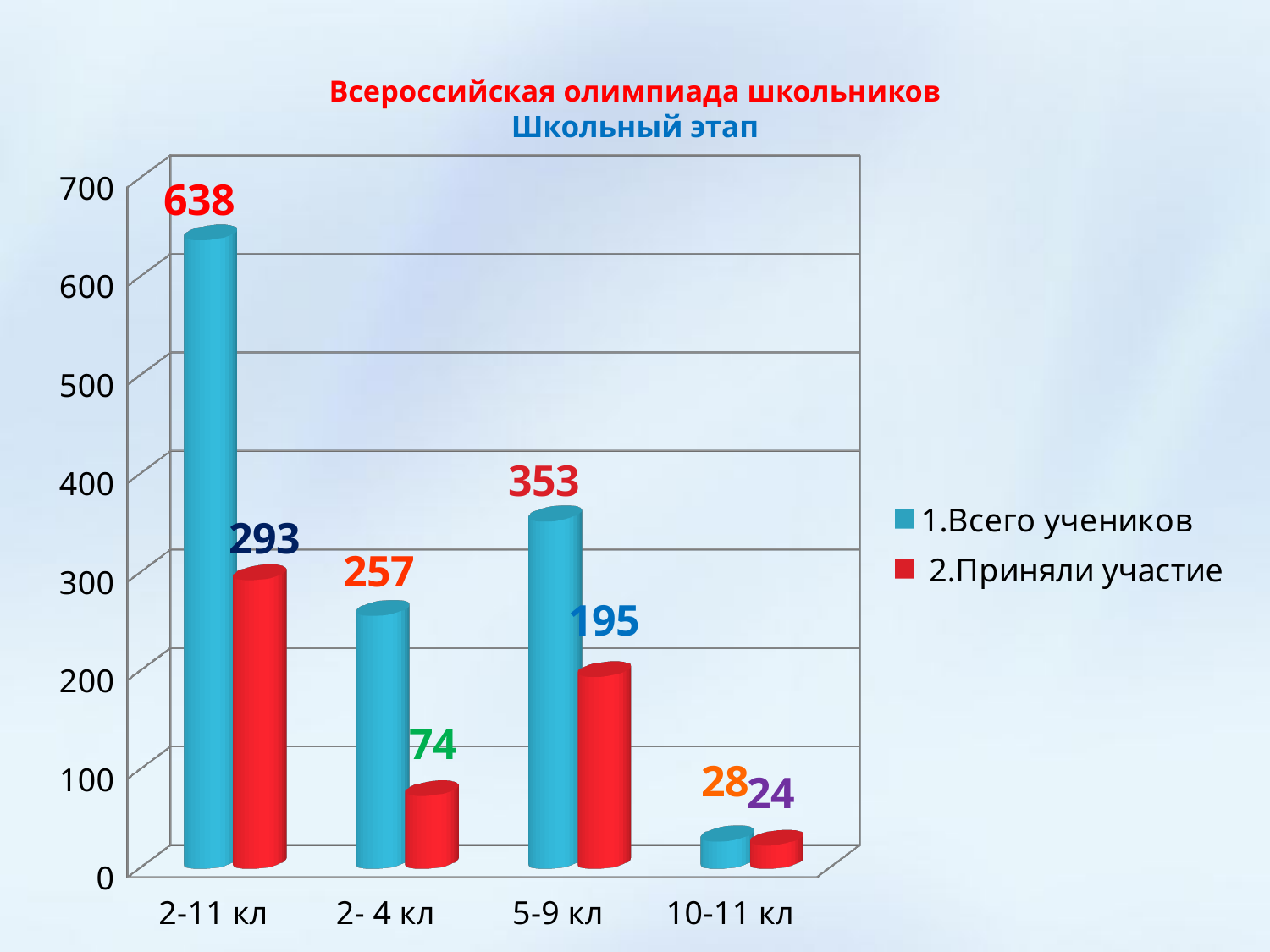
Which is larger: "2.Приняли участие" for "2-11 кл" or "1.Всего учеников" for "2- 4 кл"? 2.Приняли участие for 2-11 кл Which category has the highest value for "1.Всего учеников"? 2-11 кл What kind of chart is shown on the slide? Bar chart How many categories are shown on the x axis? 4 What is the title of the chart? Всероссийская олимпиада школьников Школьный этап What is the value of "1.Всего учеников" for "2-11 кл"? 638 What is the value of "2.Приняли участие" for "5-9 кл"? 195 What is the difference between "1.Всего учеников" and "2.Приняли участие" for "5-9 кл"? 158 How many series does the legend list? 2 What is the value of "2.Приняли участие" for "2- 4 кл"? 74 What is the value of "1.Всего учеников" for "10-11 кл"? 28 Which category has the lowest value for "2.Приняли участие"? 10-11 кл